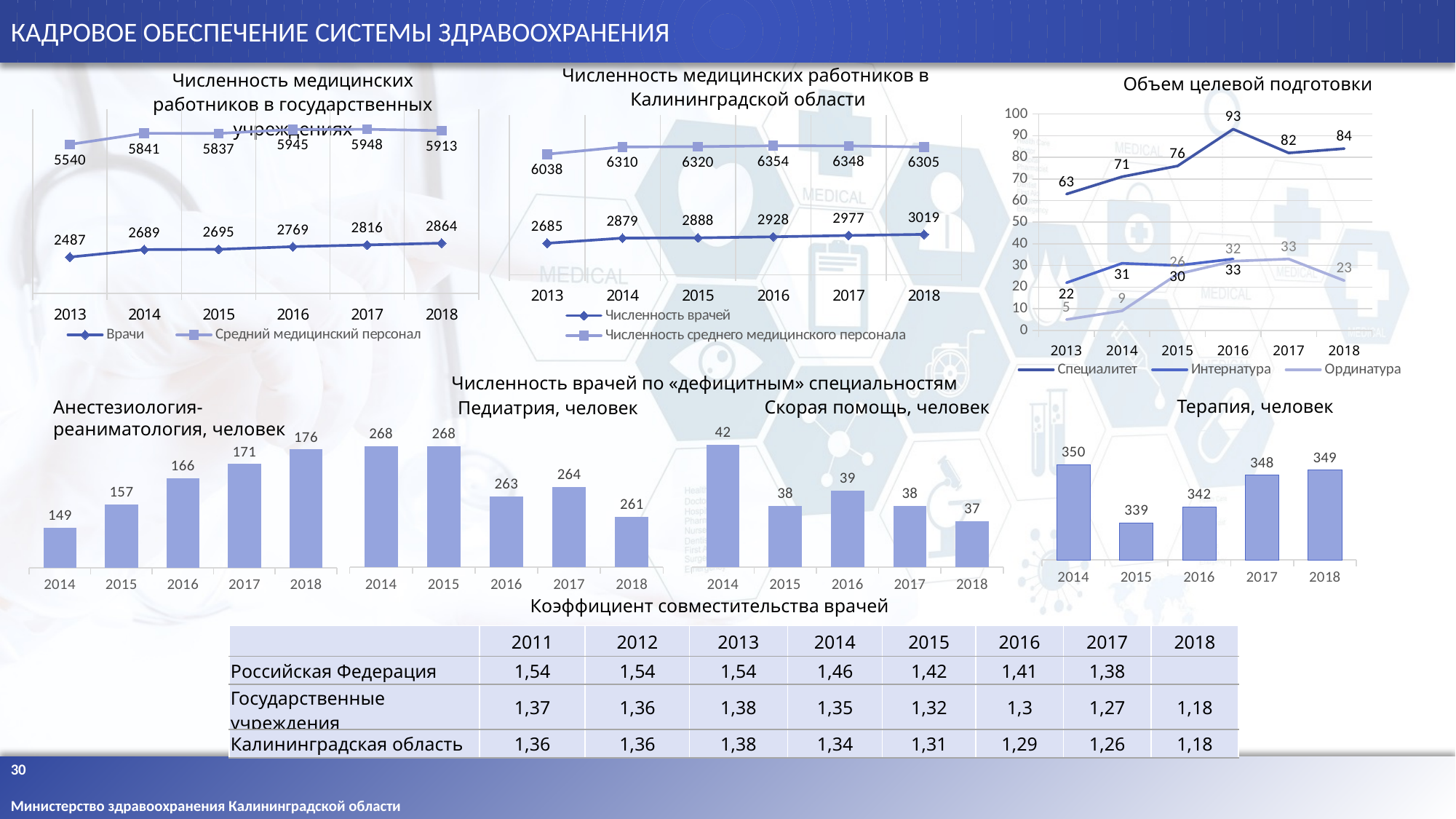
In the chart 'Численность медицинских работников в Калининградской области', by how much did Численность среднего медицинского персонала change from 2013 to 2014? 272 In the chart 'Педиатрия, человек', which year has the lowest value? 2018 In the chart 'Объем целевой подготовки', in which year is the Специалитет value highest? 2016 How many series does the legend of the chart 'Объем целевой подготовки' list? 3 What kind of chart is 'Терапия, человек'? bar chart In the chart 'Терапия, человек', which is larger: the value for 2015 or the value for 2017? 2017 In the chart 'Численность медицинских работников в государственных учреждениях', what is the value for Врачи in 2018? 2864 In the chart 'Скорая помощь, человек', what is the difference between the 2014 and 2018 values? 5 In the chart 'Объем целевой подготовки', what is the Ординатура value in 2018? 23 In the chart 'Численность медицинских работников в Калининградской области', what is the value for Численность врачей in 2016? 2928 In the chart 'Анестезиология-реаниматология, человек', do the values rise or fall from 2014 to 2018? rise In the chart 'Численность медицинских работников в государственных учреждениях', what is the value for Средний медицинский персонал in 2013? 5540